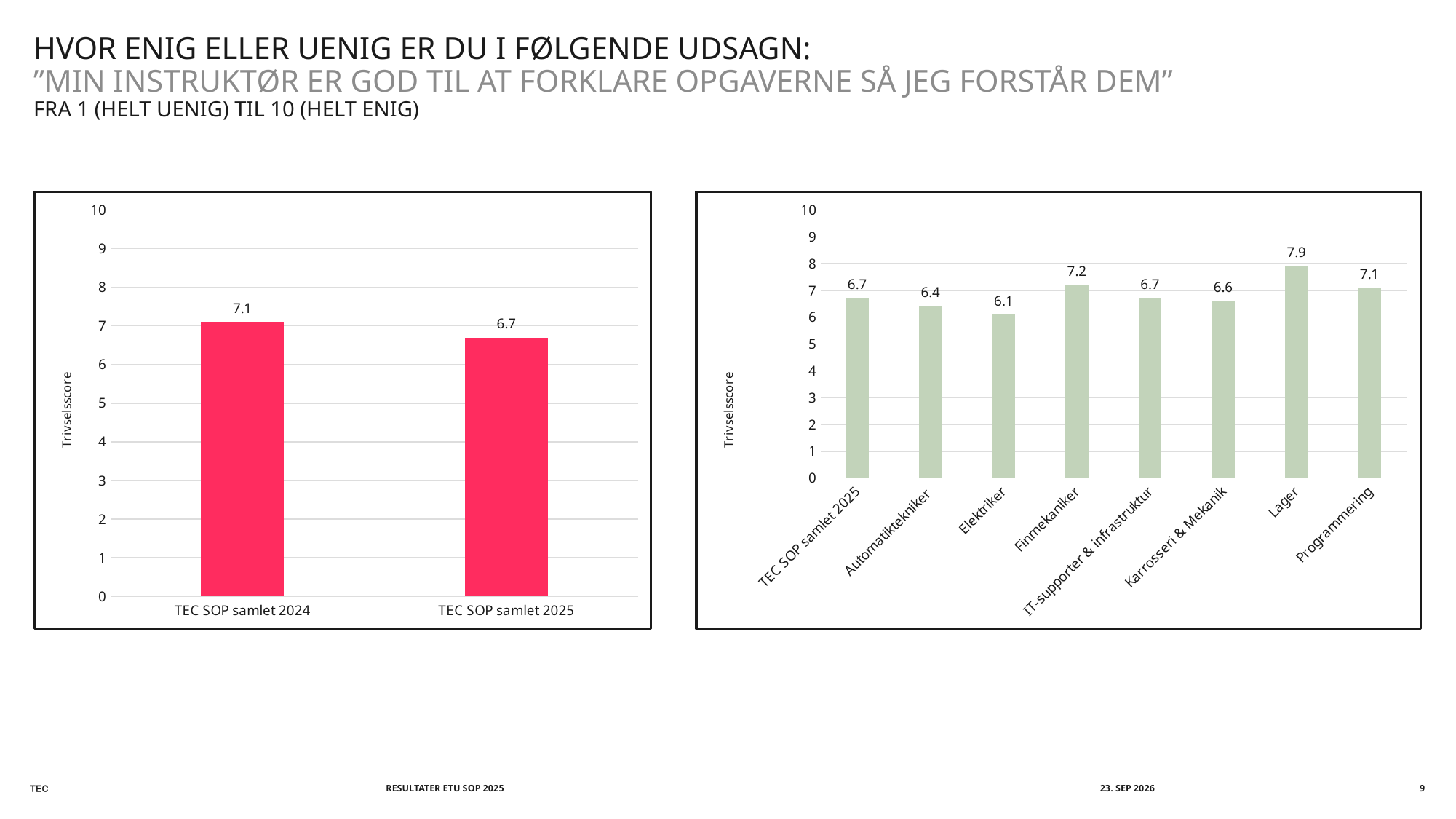
In the left chart, how many bars are plotted? 2 In the left chart, do the values rise or fall from 2024 to 2025? fall In the left chart, what is the value for TEC SOP samlet 2025? 6.7 In the right chart, which category has the highest value? Lager What kind of chart is the right chart? bar chart In the right chart, which is larger, the value for Finmekaniker or the value for Automatiktekniker? Finmekaniker In the right chart, how many categories are plotted? 8 In the left chart, what is the value for TEC SOP samlet 2024? 7.1 In the right chart, what is the value for Lager? 7.9 In the right chart, which category has the lowest value? Elektriker In the right chart, what is the value for Elektriker? 6.1 In the left chart, what is the difference between the values for TEC SOP samlet 2024 and TEC SOP samlet 2025? 0.4